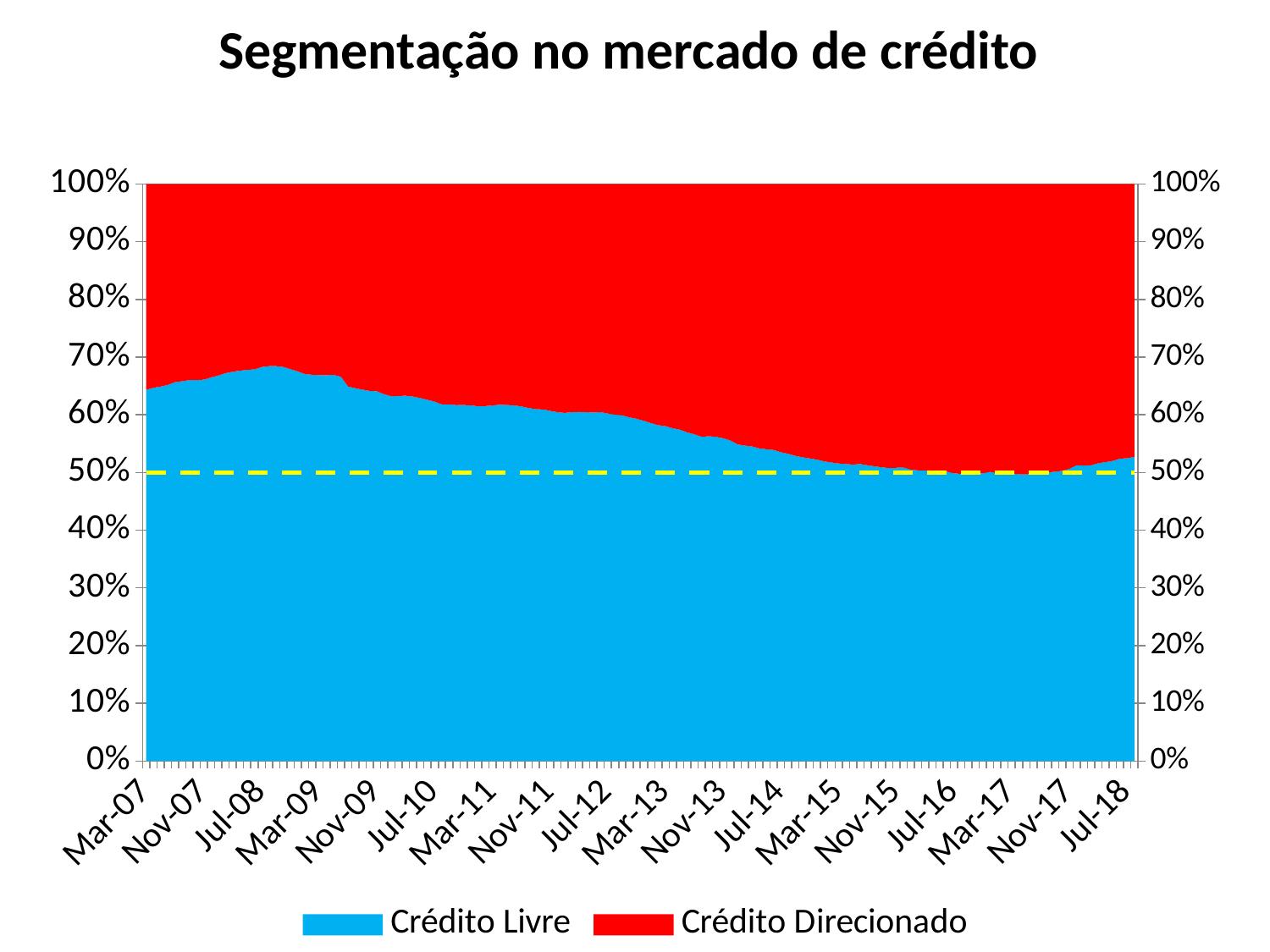
Is the share of Crédito Direcionado at Mar-15 greater or less than 40%? greater What is the title of the chart? Segmentação no mercado de crédito Is the share of Crédito Livre at Jul-08 greater or less than 60%? greater Does the share of Crédito Livre rise or fall from Mar-09 to Jul-16? fall At Mar-07, which series has the larger share, Crédito Livre or Crédito Direcionado? Crédito Livre What kind of chart is shown on the slide? Stacked area chart At what level is the yellow dashed horizontal line drawn? 50% Is the share of Crédito Livre at Jul-18 greater or less than 60%? less How many series does the legend list? 2 Does the share of Crédito Direcionado rise or fall from Mar-09 to Jul-16? rise